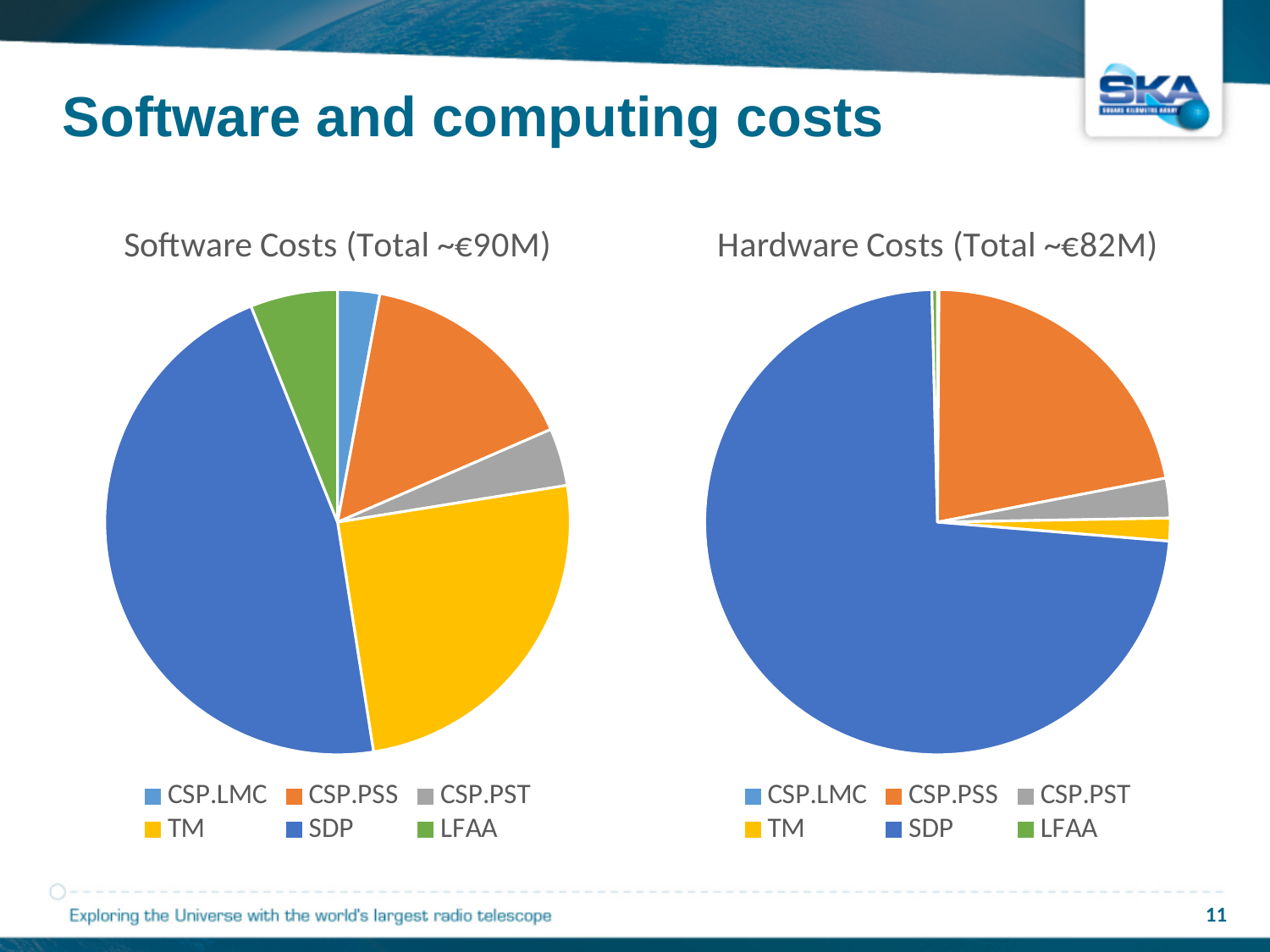
How many categories does the legend of the Software Costs chart list? 6 In the Software Costs chart, which slice is larger, CSP.PSS or LFAA? CSP.PSS What total is given in the title of the Hardware Costs chart? ~€82M How many categories does the legend of the Hardware Costs chart list? 6 What kind of chart is the Hardware Costs chart? pie chart What kind of chart is the Software Costs chart? pie chart In the Hardware Costs chart, which slice is larger, CSP.PSS or TM? CSP.PSS In the Software Costs chart, which category has the largest slice? SDP In the Software Costs chart, which slice is larger, SDP or TM? SDP What total is given in the title of the Software Costs chart? ~€90M In the Hardware Costs chart, which category has the largest slice? SDP